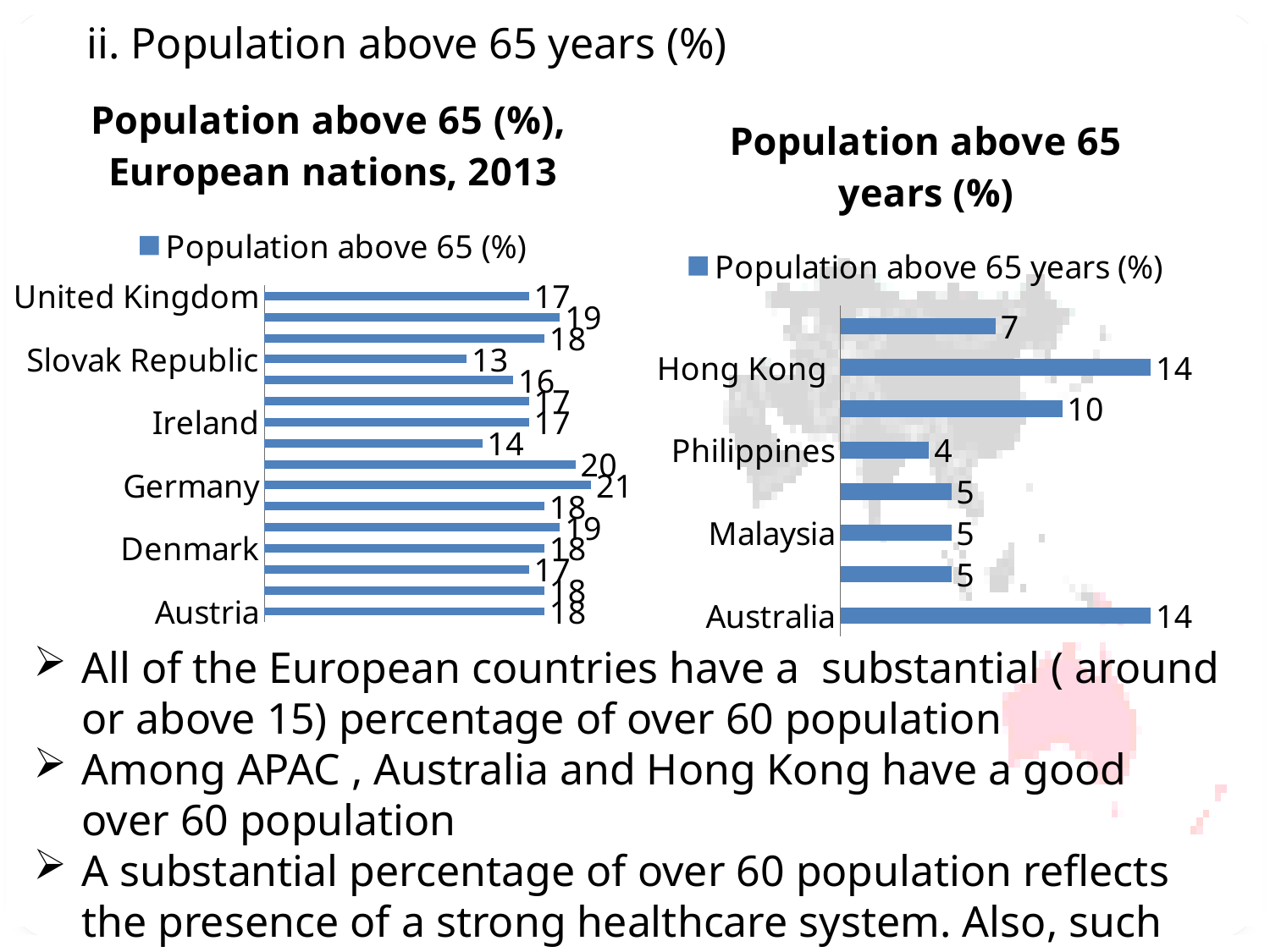
In the chart titled 'Population above 65 (%), European nations, 2013', which labelled country has the lowest value? Slovak Republic In the chart titled 'Population above 65 (%), European nations, 2013', how many bars are plotted? 16 In the chart titled 'Population above 65 (%), European nations, 2013', what is the value for Germany? 21 In the chart titled 'Population above 65 (%), European nations, 2013', what is the value for Slovak Republic? 13 In the chart titled 'Population above 65 (%), European nations, 2013', which has the larger value, Denmark or Ireland? Denmark In the chart titled 'Population above 65 (%), European nations, 2013', which labelled country has the highest value? Germany In the chart titled 'Population above 65 years (%)' on the right, what is the difference between the values for Australia and Philippines? 10 In the chart titled 'Population above 65 (%), European nations, 2013', what is the difference between the values for Germany and Slovak Republic? 8 In the chart titled 'Population above 65 years (%)' on the right, what is the value for Hong Kong? 14 What kind of chart is the chart titled 'Population above 65 years (%)' on the right? bar chart In the chart titled 'Population above 65 years (%)' on the right, which labelled country has the lowest value? Philippines In the chart titled 'Population above 65 years (%)' on the right, what is the value for Philippines? 4